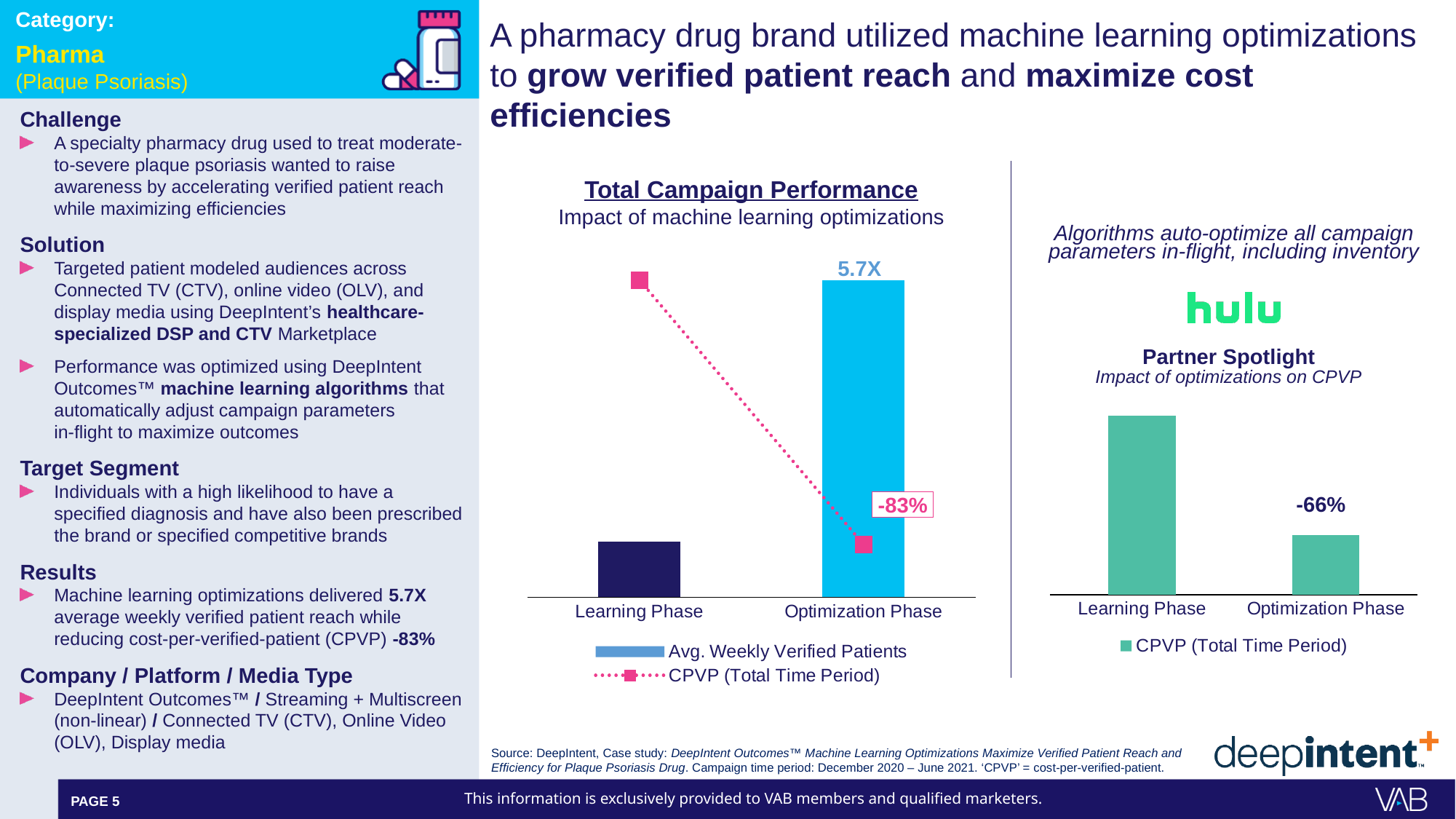
What is the subtitle under the Total Campaign Performance chart title? Impact of machine learning optimizations In the Partner Spotlight chart, which phase has the lower CPVP bar? Optimization Phase In the Total Campaign Performance chart, is the CPVP value higher in the Learning Phase or the Optimization Phase? Learning Phase In the Total Campaign Performance chart, which phase has the taller Avg. Weekly Verified Patients bar? Optimization Phase How many series does the legend of the Total Campaign Performance chart list? 2 In the Total Campaign Performance chart, what data label is shown on the Optimization Phase bar for Avg. Weekly Verified Patients? 5.7X In the Total Campaign Performance chart, what data label is shown for CPVP (Total Time Period) at the Optimization Phase? -83% Which partner's logo appears above the Partner Spotlight chart? hulu What kind of chart is the Partner Spotlight chart? Bar chart In the Partner Spotlight chart, what data label is shown on the Optimization Phase bar? -66% In the Total Campaign Performance chart, does the CPVP line rise or fall from Learning Phase to Optimization Phase? Fall How many categories are shown on the x axis of the Partner Spotlight chart? 2